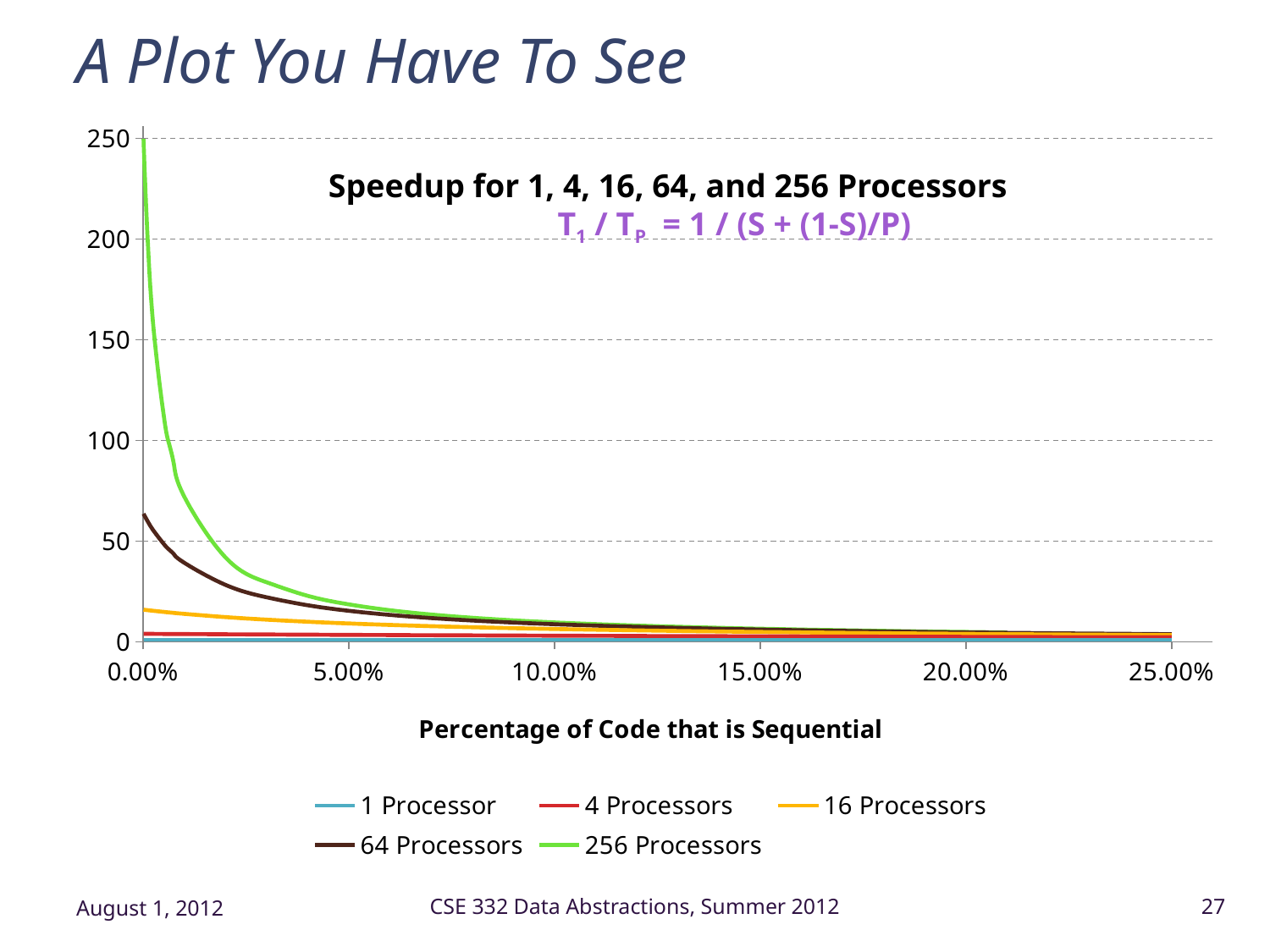
Which series has the highest value at 0.00% sequential code? 256 Processors Is the value for 256 Processors at 0.00% greater or less than 200? greater At 0.00% sequential code, which is larger: the value for 256 Processors or the value for 64 Processors? 256 Processors Is the value for 64 Processors at 0.00% greater or less than 50? greater What kind of chart is shown on the slide? line chart Is the value for 16 Processors at 0.00% greater or less than 50? less What is the label of the x axis? Percentage of Code that is Sequential How many series does the legend list? 5 Does the 256 Processors line rise or fall as the percentage of sequential code increases? fall What is the title of the chart? Speedup for 1, 4, 16, 64, and 256 Processors Does the 64 Processors line rise or fall along the x axis? fall